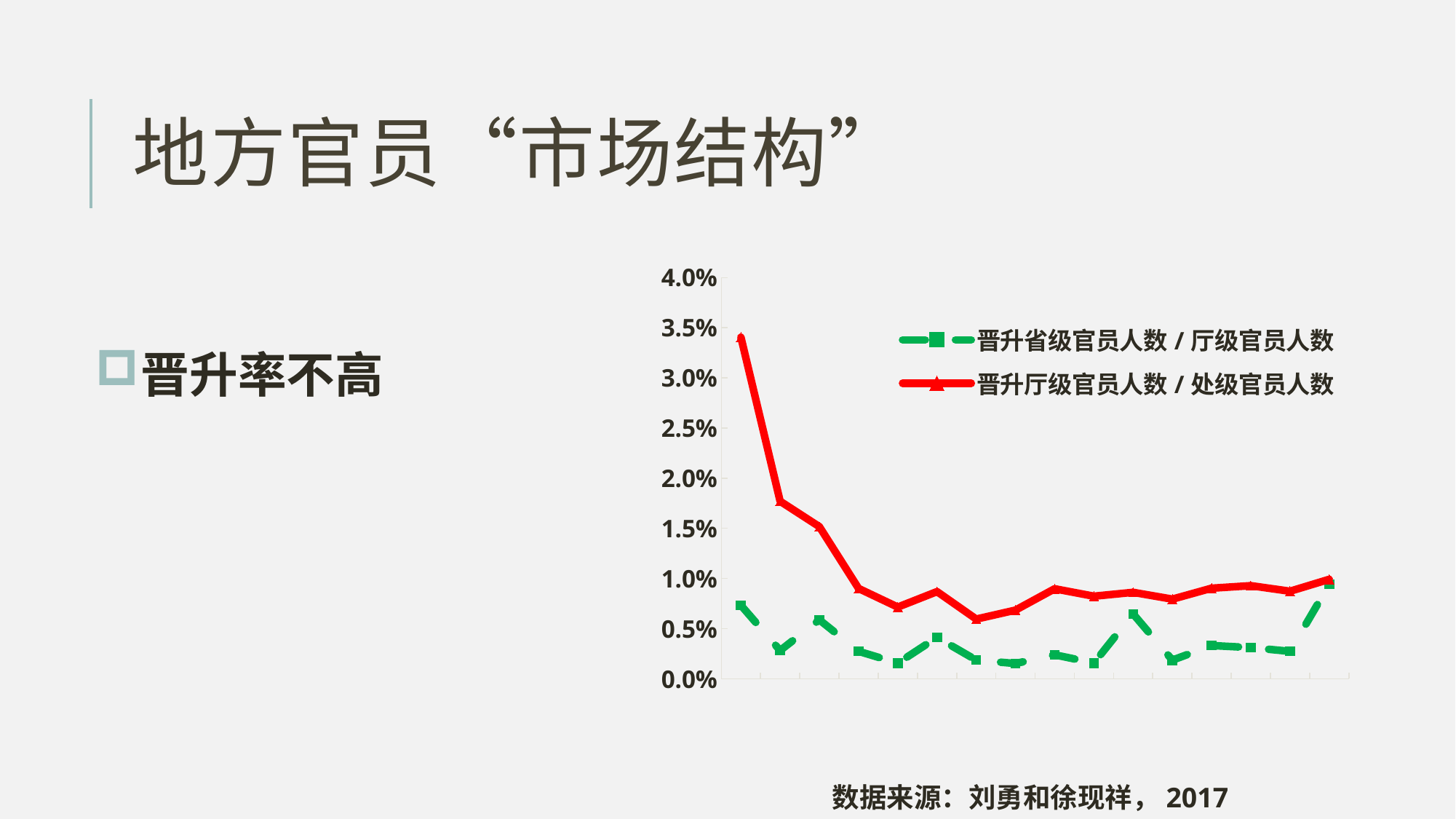
What kind of chart is shown on the slide? line chart Which series has the lowest value on the chart? 晋升省级官员人数 / 厅级官员人数 How many data points does each series have? 16 At the first point, which series is larger: 晋升厅级官员人数 / 处级官员人数 or 晋升省级官员人数 / 厅级官员人数? 晋升厅级官员人数 / 处级官员人数 How many series does the legend list? 2 Does the 晋升厅级官员人数 / 处级官员人数 series rise or fall over its first four points? fall Which series reaches the highest value on the chart? 晋升厅级官员人数 / 处级官员人数 Which series is drawn as a dashed green line? 晋升省级官员人数 / 厅级官员人数 Is the second value of the 晋升厅级官员人数 / 处级官员人数 series greater or less than 1.5%? greater Which series is drawn as a solid red line? 晋升厅级官员人数 / 处级官员人数 Is the first value of the 晋升省级官员人数 / 厅级官员人数 series greater or less than 1.0%? less Is the first value of the 晋升厅级官员人数 / 处级官员人数 series greater or less than 3.0%? greater